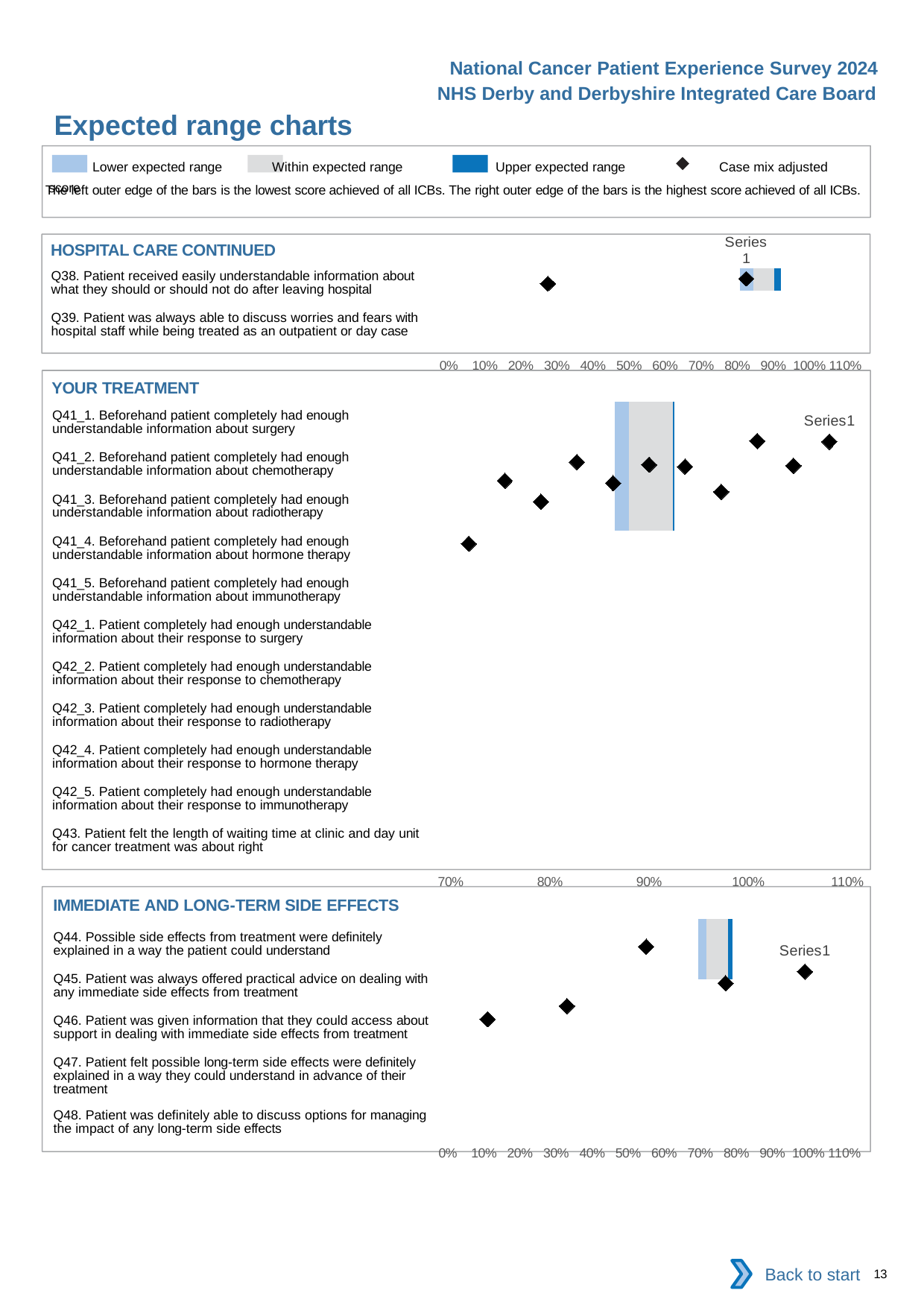
What is the lowest value shown on the x axis of the YOUR TREATMENT chart? 70% How many questions (categories) are listed in the HOSPITAL CARE CONTINUED chart? 2 How many questions (categories) are listed in the YOUR TREATMENT chart? 11 What is the highest tick shown on the x axis of the IMMEDIATE AND LONG-TERM SIDE EFFECTS chart? 110% How many entries does the legend at the top of the slide list? 4 How many questions (categories) are listed in the IMMEDIATE AND LONG-TERM SIDE EFFECTS chart? 5 In the legend at the top of the slide, what does the diamond marker represent? Case mix adjusted score